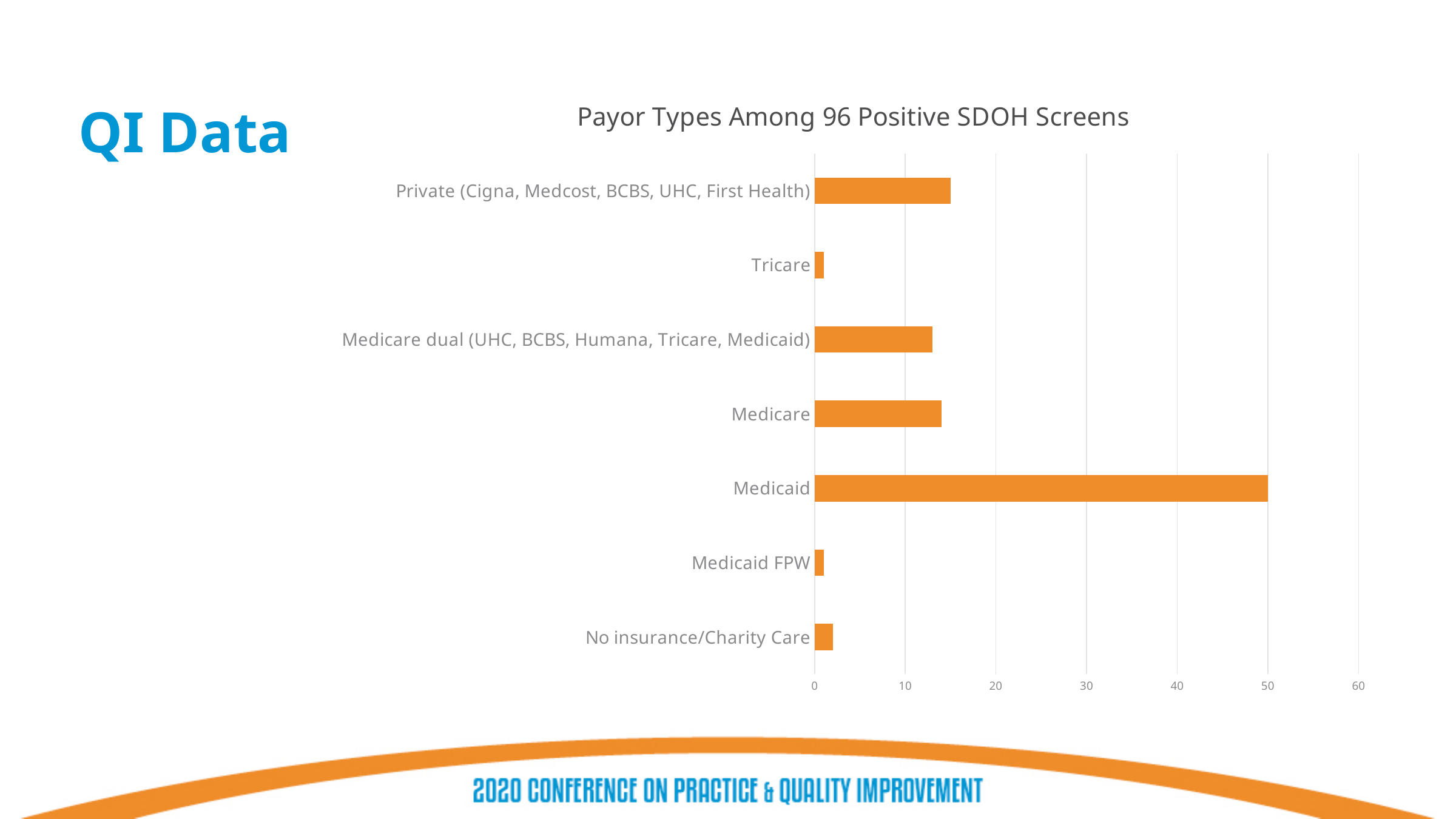
Is the value for Medicare greater or less than 20? less Which payor type has the highest number of positive SDOH screens? Medicaid Is the value for Medicaid greater or less than 40? greater How many payor type categories are shown in the chart? 7 Is the value for No insurance/Charity Care greater or less than 10? less What type of chart is shown on the slide? Bar chart What is the value for Medicaid? 50 What is the title of the chart? Payor Types Among 96 Positive SDOH Screens Which is larger, the value for Medicaid or the value for Medicare? Medicaid What colour are the bars in the chart? Orange